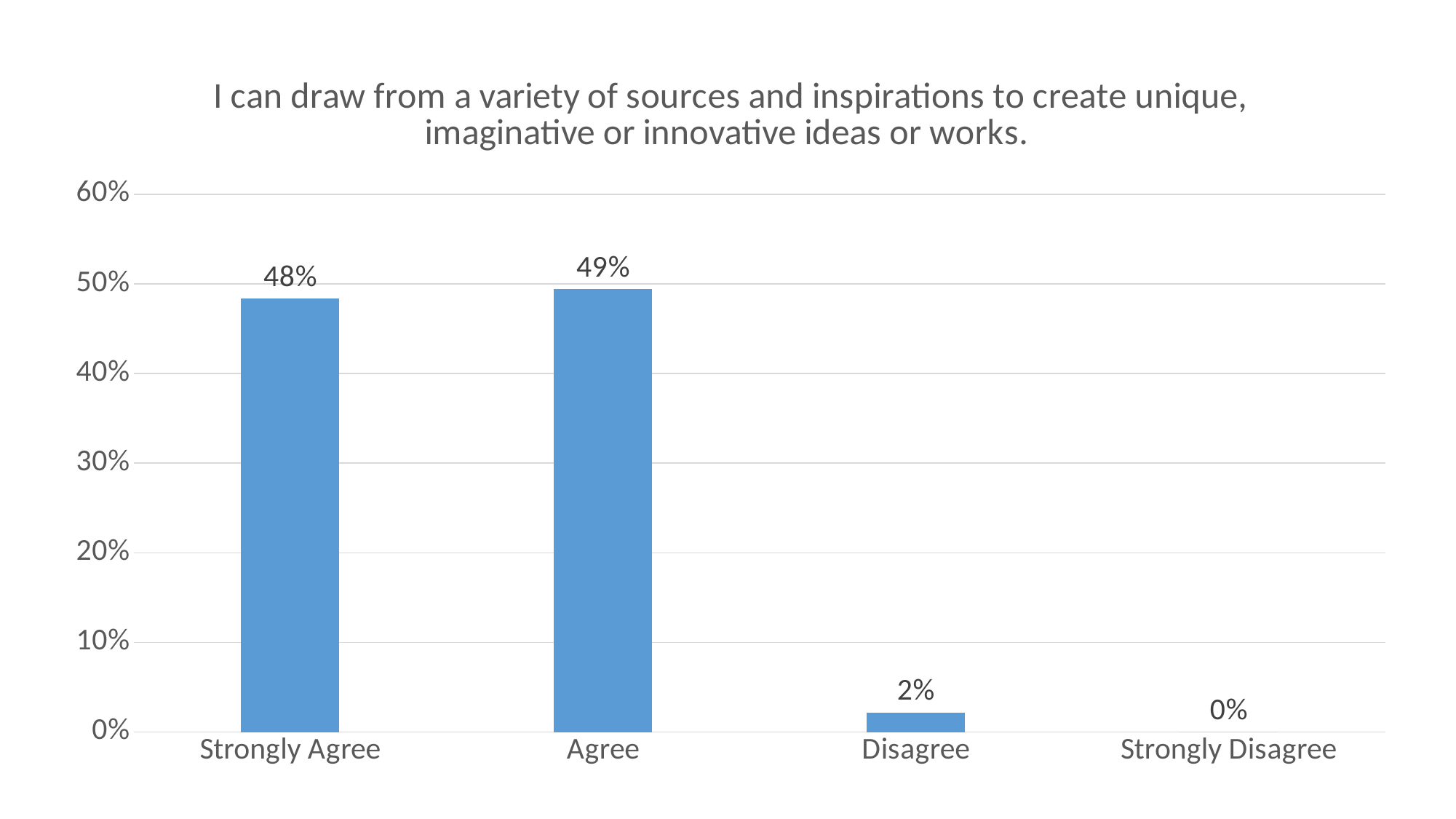
What is the difference between the values for Agree and Strongly Agree? 1% How many categories are shown on the x axis? 4 What is the value for Agree? 49% Which is larger, the value for Strongly Agree or the value for Disagree? Strongly Agree What is the difference between the values for Strongly Agree and Disagree? 46% Which category has the highest value? Agree What is the value for Strongly Disagree? 0% Which category has the lowest value? Strongly Disagree What kind of chart is this? Bar chart What is the value for Strongly Agree? 48% What is the value for Disagree? 2% What is the title of the chart? I can draw from a variety of sources and inspirations to create unique, imaginative or innovative ideas or works.